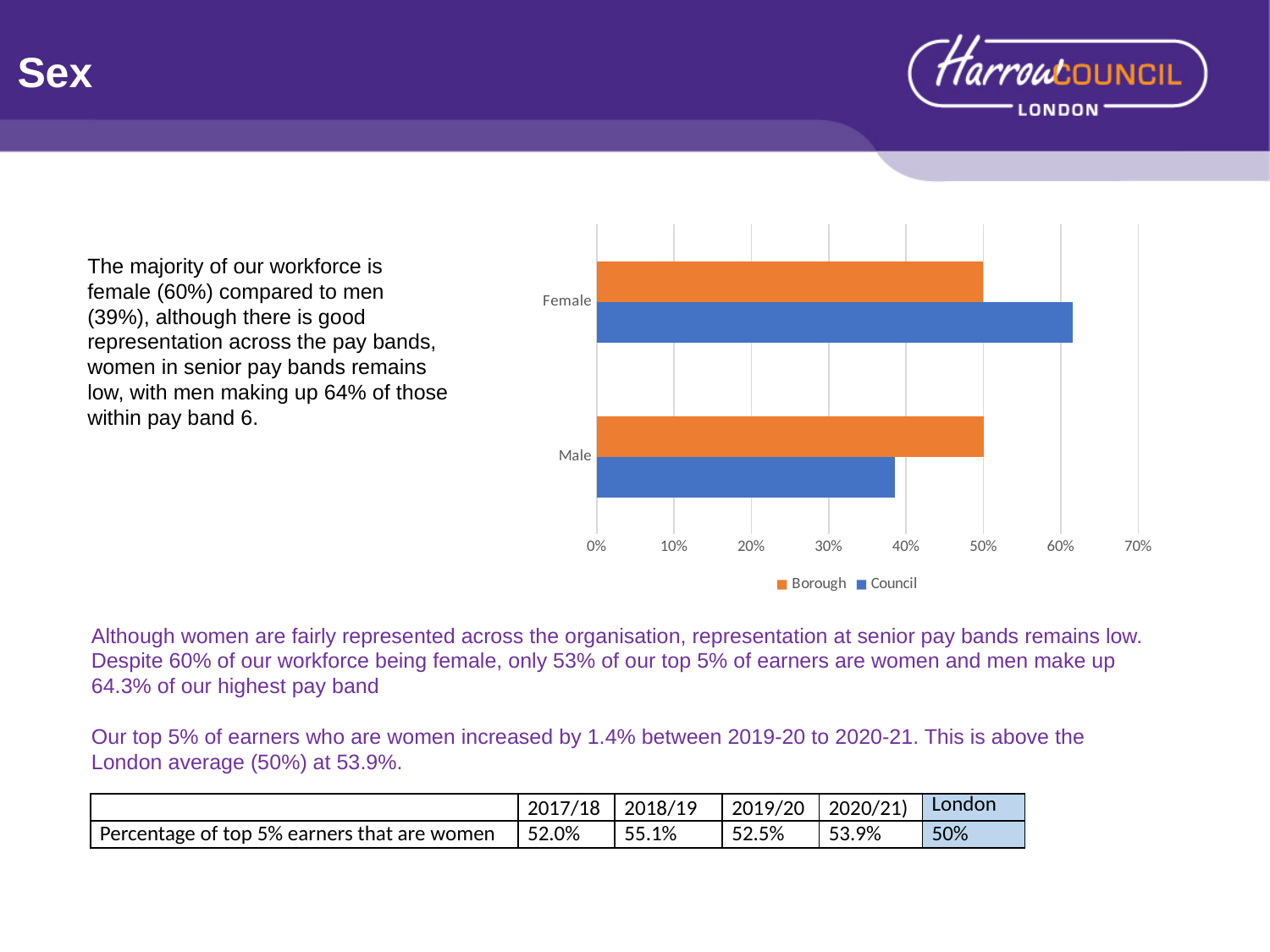
Which is larger, the Council value for Female or the Council value for Male? Female How many series does the chart's legend list? 2 Is the Council value for Male greater or less than 50%? less Is the Council value for Female greater or less than 50%? greater What are the two entries in the chart's legend? Borough and Council Which category has the highest Council value? Female Is the Council value for Female greater or less than 40%? greater What kind of chart is shown on the slide? bar chart How many categories are shown on the chart's vertical axis? 2 What colour are the Council bars in the chart? blue